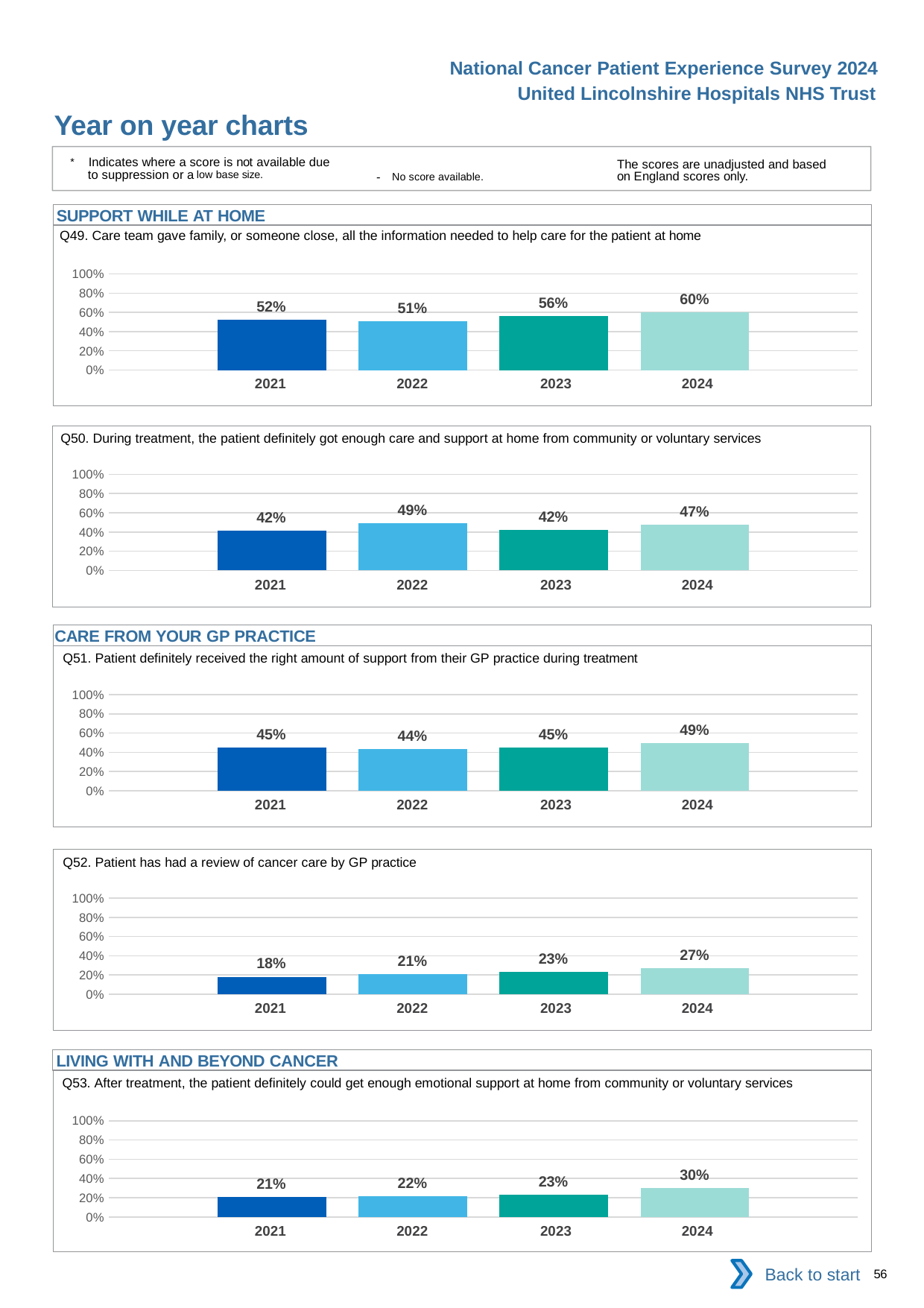
In the Q49 chart, is the value for 2023 greater or less than 40%? greater In the Q50 chart, what is the difference between the 2022 and 2021 values? 7% In the Q52 chart, do the values rise or fall from 2021 to 2024? rise In the Q51 chart, is the value for 2024 larger or smaller than the value for 2021? larger What kind of chart is the Q52 chart? bar chart In the Q50 chart, which year has the highest value? 2022 In the Q52 chart, what is the value for 2021? 18% In the Q53 chart, how many years are shown on the x axis? 4 In the Q53 chart, what is the difference between the 2024 and 2023 values? 7% In the Q49 chart, which year has the lowest value? 2022 In the Q49 chart, what is the value for 2024? 60% In the Q51 chart, what is the value for 2022? 44%